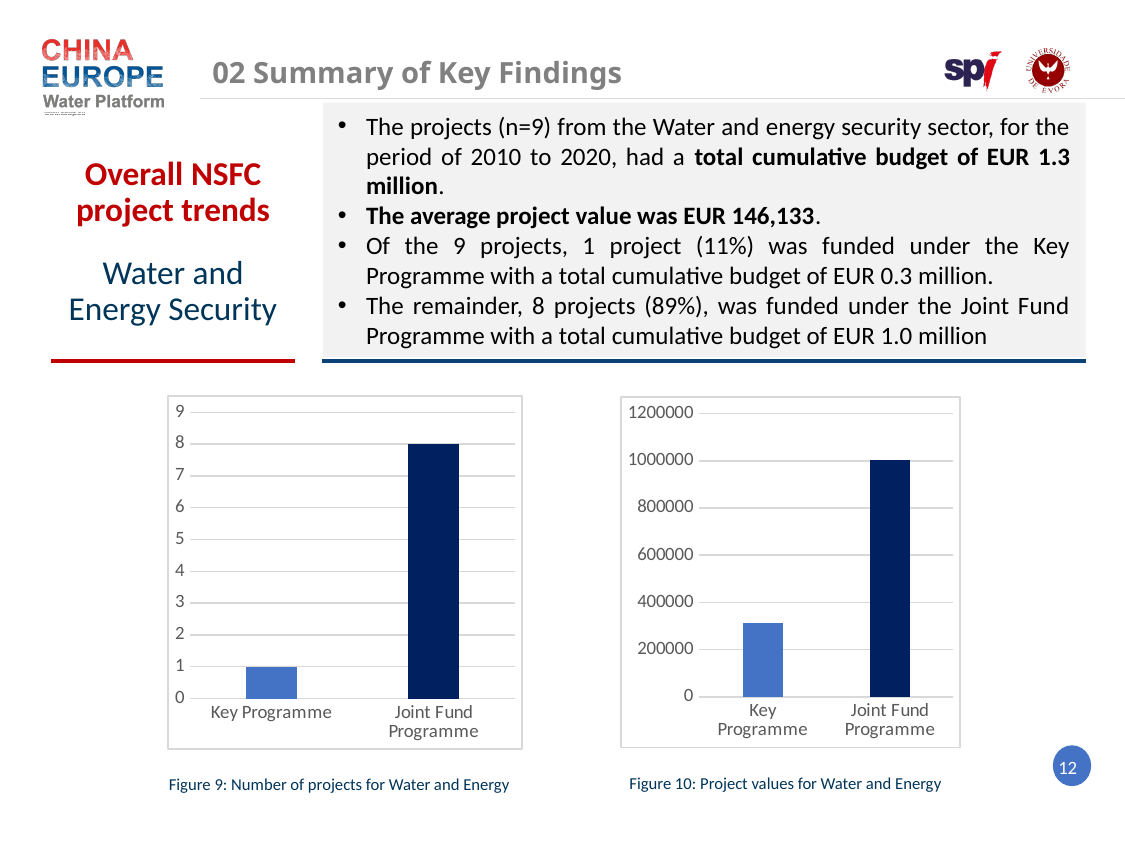
In the left chart (Figure 9: Number of projects for Water and Energy), what is the value for Joint Fund Programme? 8 How many categories are shown in the left chart (Figure 9)? 2 In the right chart (Figure 10), is the value for Key Programme greater or less than 400000? less In the left chart (Figure 9: Number of projects for Water and Energy), what is the value for Key Programme? 1 In the right chart (Figure 10), which category has the lowest value? Key Programme In the right chart (Figure 10), is the value for Key Programme greater or less than 200000? greater In the right chart (Figure 10), which is larger, the value for Key Programme or Joint Fund Programme? Joint Fund Programme What kind of chart is the right chart (Figure 10)? Bar chart In the left chart (Figure 9), what is the difference between the Joint Fund Programme and Key Programme values? 7 In the left chart (Figure 9), which category has the highest value? Joint Fund Programme What is the caption of the left chart? Figure 9: Number of projects for Water and Energy